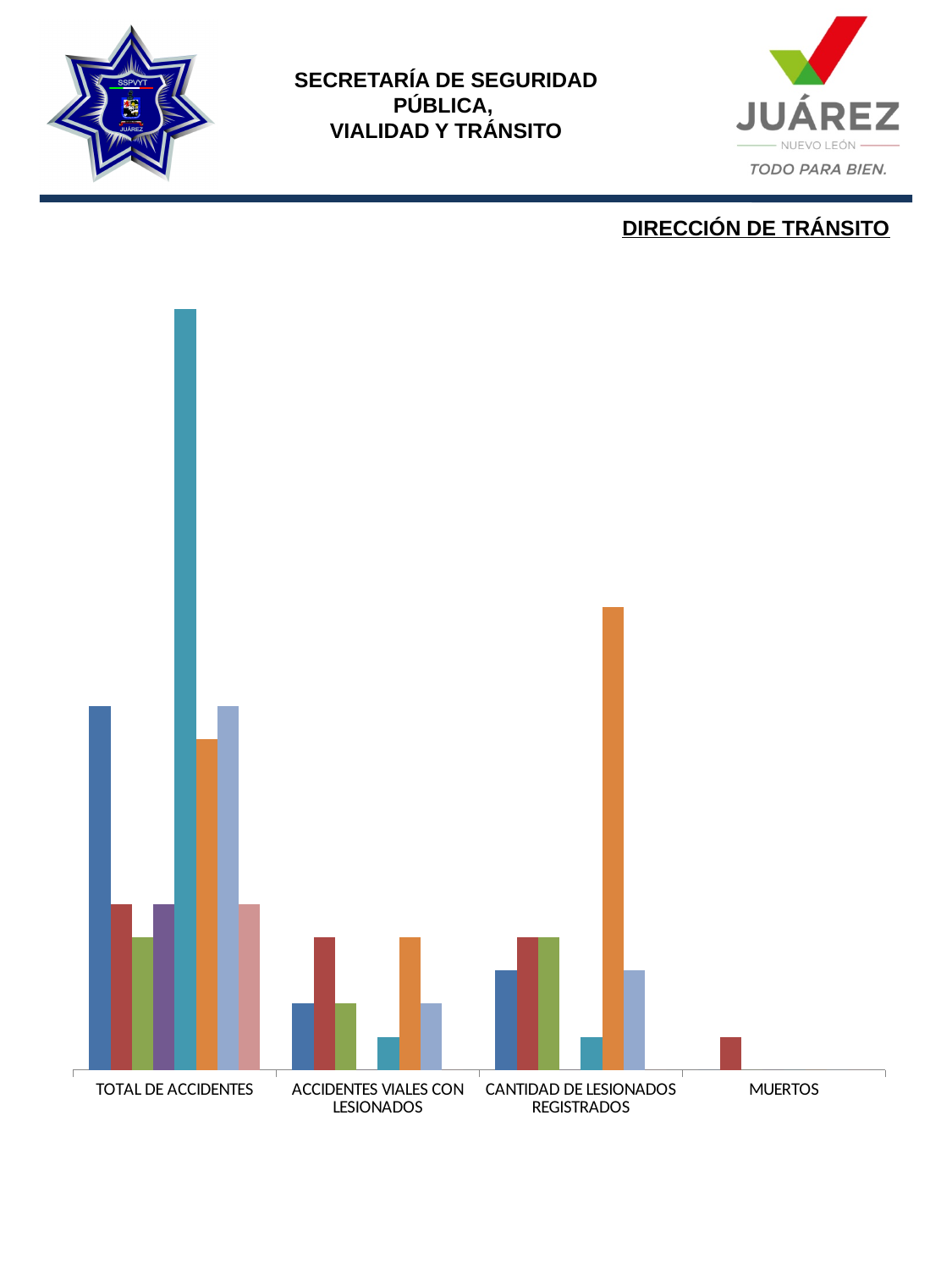
Which is taller: the tallest bar in ACCIDENTES VIALES CON LESIONADOS or the tallest bar in CANTIDAD DE LESIONADOS REGISTRADOS? CANTIDAD DE LESIONADOS REGISTRADOS What kind of chart is shown on the slide? bar chart What is the label of the first category on the x axis? TOTAL DE ACCIDENTES What is the label of the last category on the x axis? MUERTOS Which is taller: the tallest bar in TOTAL DE ACCIDENTES or the tallest bar in CANTIDAD DE LESIONADOS REGISTRADOS? TOTAL DE ACCIDENTES Which category contains the tallest bar in the chart? TOTAL DE ACCIDENTES How many bars are visible in the MUERTOS category? 1 Which category has the fewest visible bars in the chart? MUERTOS How many categories are shown on the x axis of the chart? 4